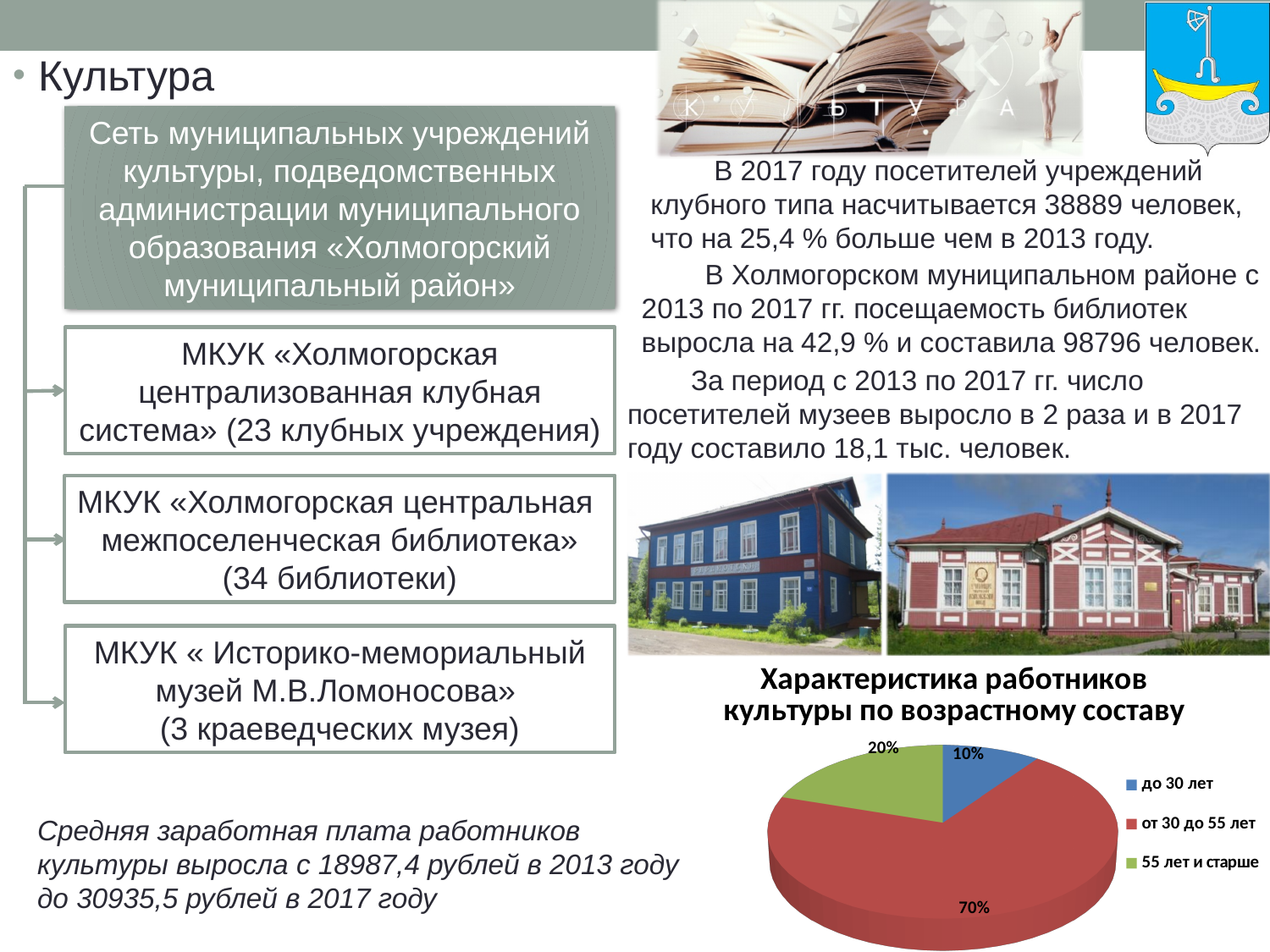
What is the title of the chart on the slide? Характеристика работников культуры по возрастному составу What type of chart is shown on the slide? pie chart Which slice is larger in the pie chart: «55 лет и старше» or «до 30 лет»? 55 лет и старше How many entries does the legend of the pie chart list? 3 Which age group has the largest slice in the pie chart? от 30 до 55 лет Which age group has the smallest slice in the pie chart? до 30 лет What is the difference in percentage points between the «от 30 до 55 лет» slice and the «55 лет и старше» slice? 50 What share of the pie chart is labelled «до 30 лет»? 10% What colour is the «от 30 до 55 лет» slice in the pie chart? red How many slices does the pie chart have? 3 What share of the pie chart is labelled «от 30 до 55 лет»? 70% What share of the pie chart is labelled «55 лет и старше»? 20%